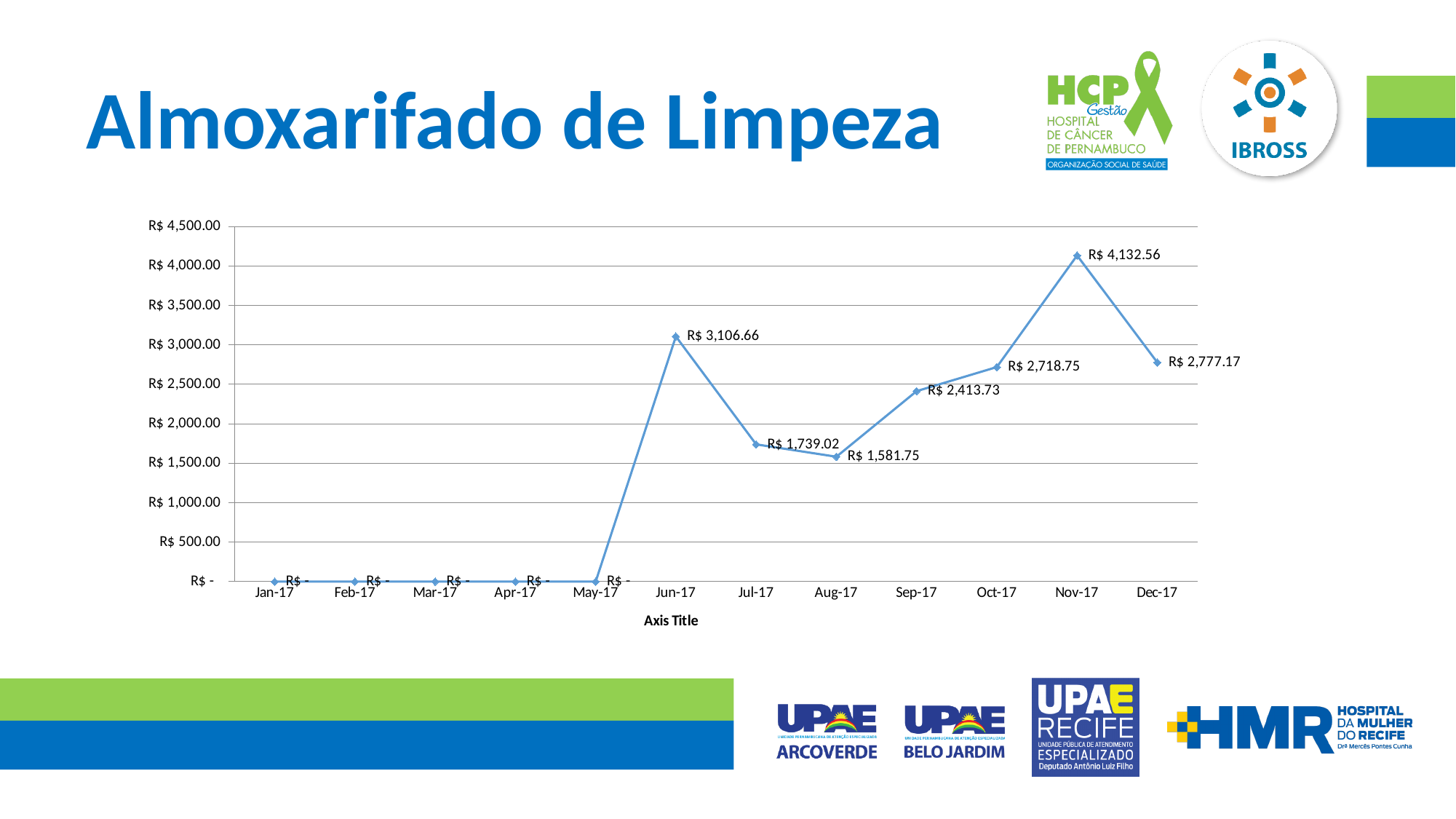
What is the difference between the values for Nov-17 and Dec-17? R$ 1,355.39 What is the value for Nov-17? R$ 4,132.56 Among the months from Jun-17 to Dec-17, which has the lowest value? Aug-17 What kind of chart is shown on the slide? line chart Is the value for Oct-17 greater or less than R$ 2,500.00? greater What is the value for Dec-17? R$ 2,777.17 What is the difference between the values for Oct-17 and Sep-17? R$ 305.02 What is the value for Jun-17? R$ 3,106.66 How many months are plotted on the x axis? 12 What is the value for Aug-17? R$ 1,581.75 Which month has the highest value? Nov-17 Which is larger, the value for Jul-17 or the value for Sep-17? Sep-17